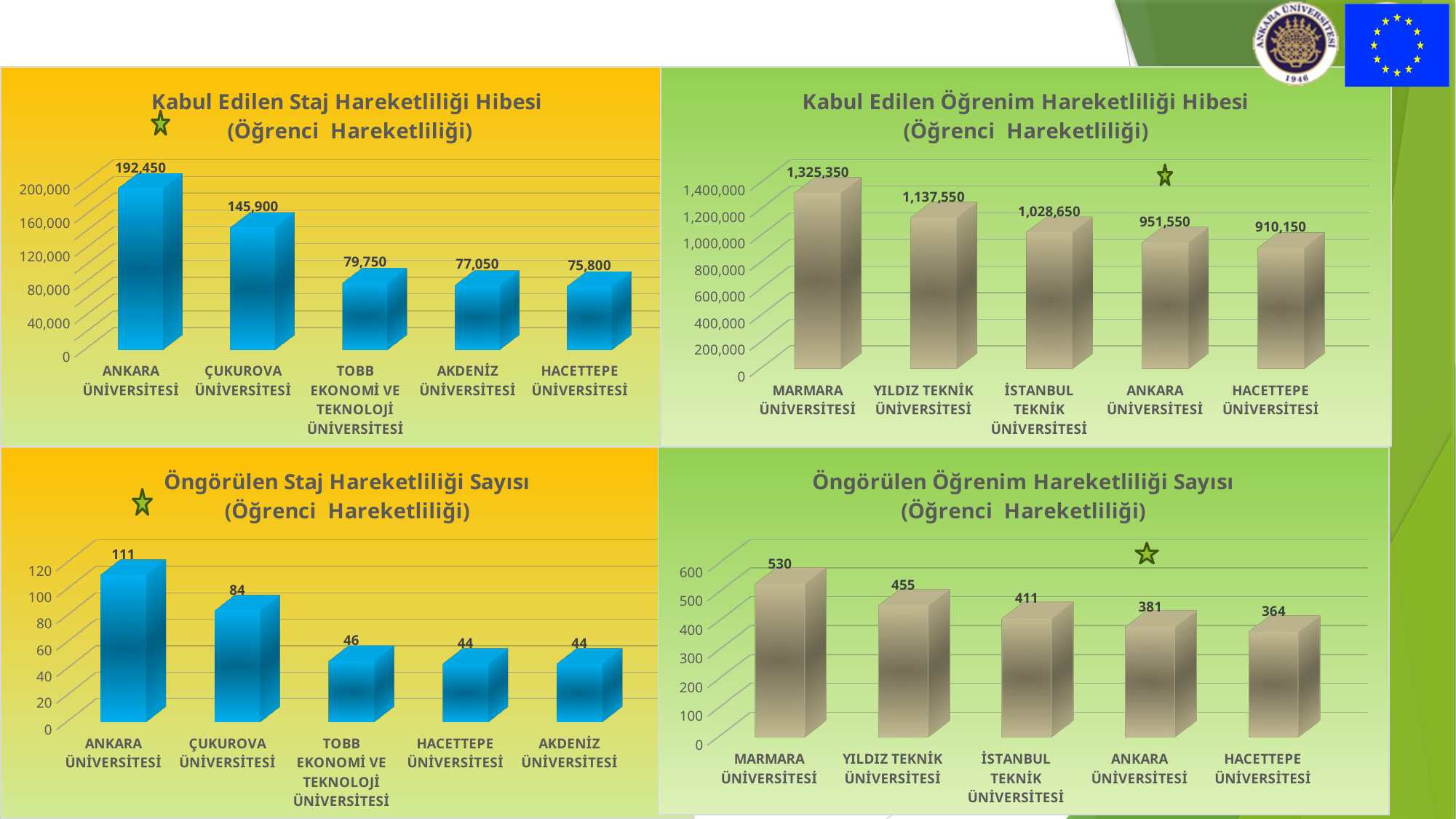
In the 'Öngörülen Öğrenim Hareketliliği Sayısı' chart, do the values rise or fall from left to right? Fall In the 'Kabul Edilen Öğrenim Hareketliliği Hibesi' chart, what is the difference between MARMARA ÜNİVERSİTESİ and HACETTEPE ÜNİVERSİTESİ? 415,200 In the 'Kabul Edilen Staj Hareketliliği Hibesi' chart, which is larger: AKDENİZ ÜNİVERSİTESİ or HACETTEPE ÜNİVERSİTESİ? AKDENİZ ÜNİVERSİTESİ How many universities are shown in the 'Öngörülen Staj Hareketliliği Sayısı' chart? 5 In the 'Öngörülen Öğrenim Hareketliliği Sayısı' chart, which university has the lowest value? HACETTEPE ÜNİVERSİTESİ In the 'Kabul Edilen Staj Hareketliliği Hibesi' chart, what is the value for ANKARA ÜNİVERSİTESİ? 192,450 How many charts are shown on the slide? 4 What type of chart is the 'Kabul Edilen Öğrenim Hareketliliği Hibesi' chart? Bar chart In the 'Öngörülen Staj Hareketliliği Sayısı' chart, what is the difference between ANKARA ÜNİVERSİTESİ and ÇUKUROVA ÜNİVERSİTESİ? 27 In the 'Kabul Edilen Öğrenim Hareketliliği Hibesi' chart, what is the value for İSTANBUL TEKNİK ÜNİVERSİTESİ? 1,028,650 In the 'Kabul Edilen Öğrenim Hareketliliği Hibesi' chart, which university has the highest value? MARMARA ÜNİVERSİTESİ In the 'Öngörülen Öğrenim Hareketliliği Sayısı' chart, what is the value for YILDIZ TEKNİK ÜNİVERSİTESİ? 455